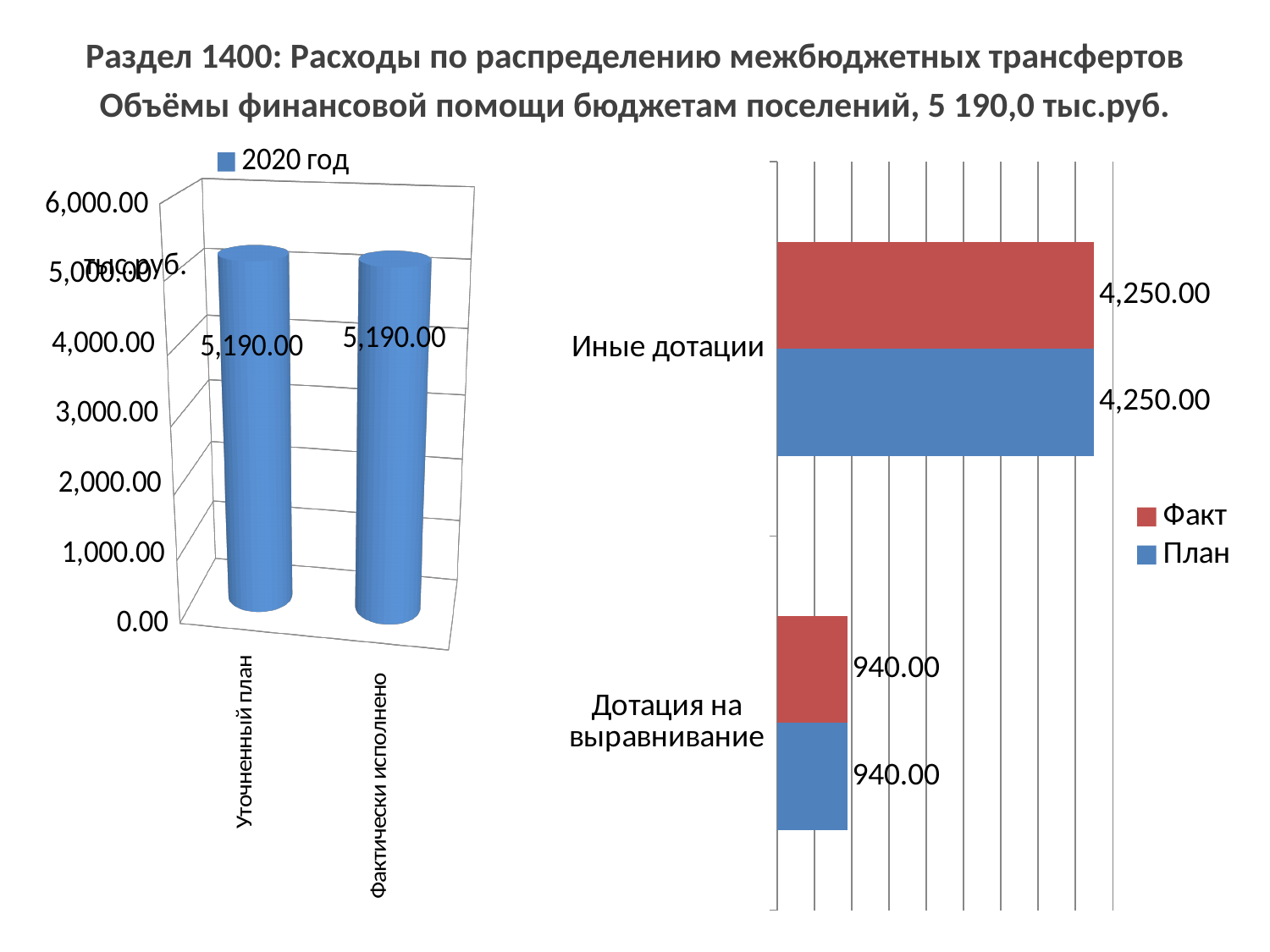
In the left chart, how many categories are shown on the x axis? 2 In the left chart, what is the value for Фактически исполнено? 5,190.00 In the right chart, which is larger: the Факт value for Дотация на выравнивание or the План value for Иные дотации? План value for Иные дотации What kind of chart is the right chart? bar chart In the right chart, which category has the higher Факт value? Иные дотации In the left chart, is the value for Уточненный план greater or less than 5,000.00? greater In the right chart, what is the Факт value for Дотация на выравнивание? 940.00 In the right chart, how many series does the legend list? 2 In the right chart, what is the План value for Иные дотации? 4,250.00 In the right chart, what is the difference between the План values for Иные дотации and Дотация на выравнивание? 3,310.00 In the left chart, what is the value for Уточненный план? 5,190.00 In the left chart, what series does the legend list? 2020 год